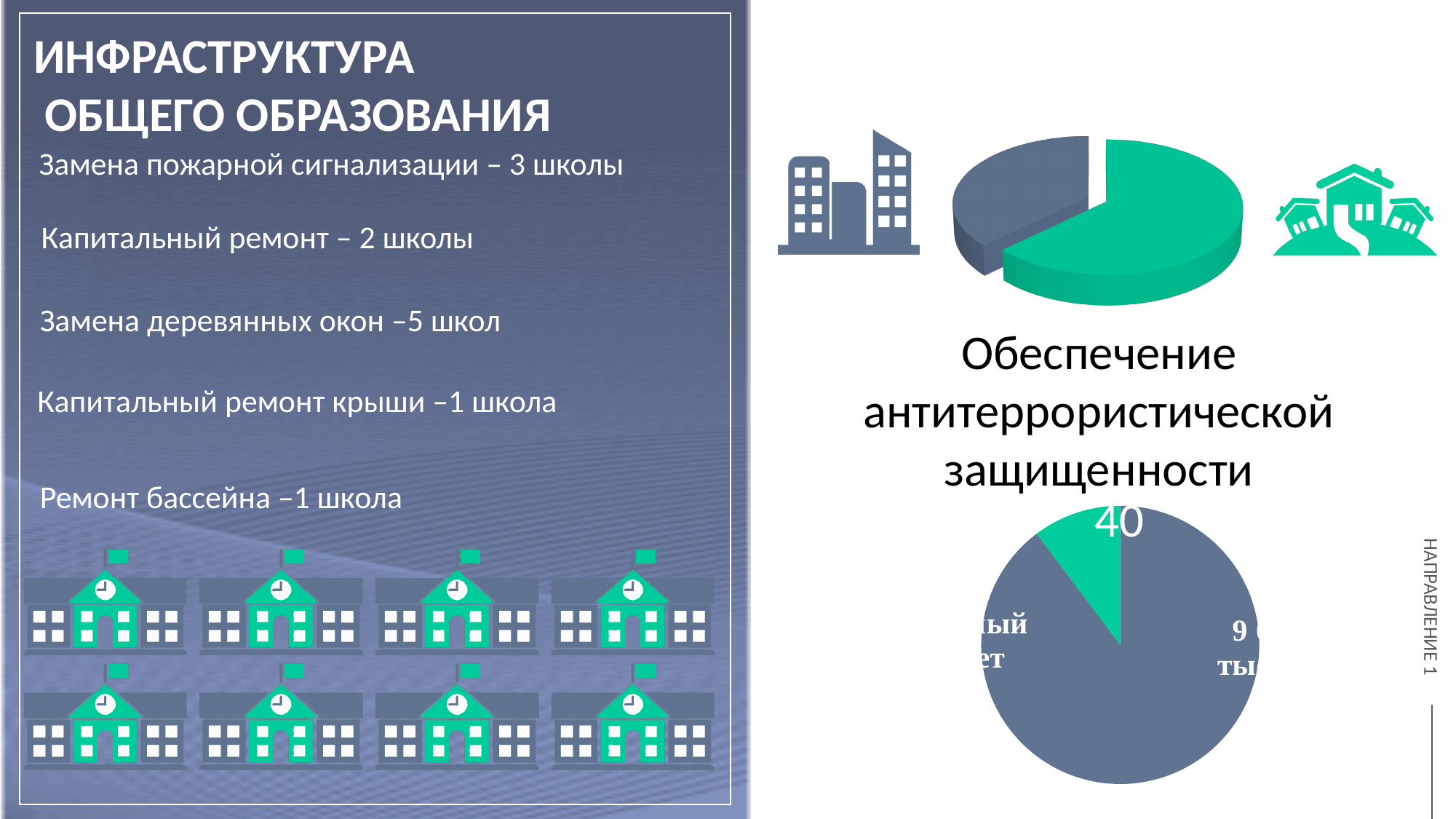
What text appears directly above the bottom-right pie chart? Обеспечение антитеррористической защищенности In the top-right pie chart, does the green slice take up more or less than half of the pie? more How many slices does the bottom-right pie chart have? 2 What number is printed on the green slice of the bottom-right pie chart? 40 What kind of chart is the chart at the bottom right of the slide, below the text 'Обеспечение антитеррористической защищенности'? pie chart In the top-right pie chart, which slice is larger, the green one or the grey one? the green one How many slices does the top-right pie chart have? 2 What kind of chart is the chart at the top right of the slide? pie chart In the bottom-right pie chart, does the green slice take up more or less than half of the pie? less What two colours are used for the slices of the top-right pie chart? green and grey In the bottom-right pie chart, which slice is larger, the green one or the grey one? the grey one